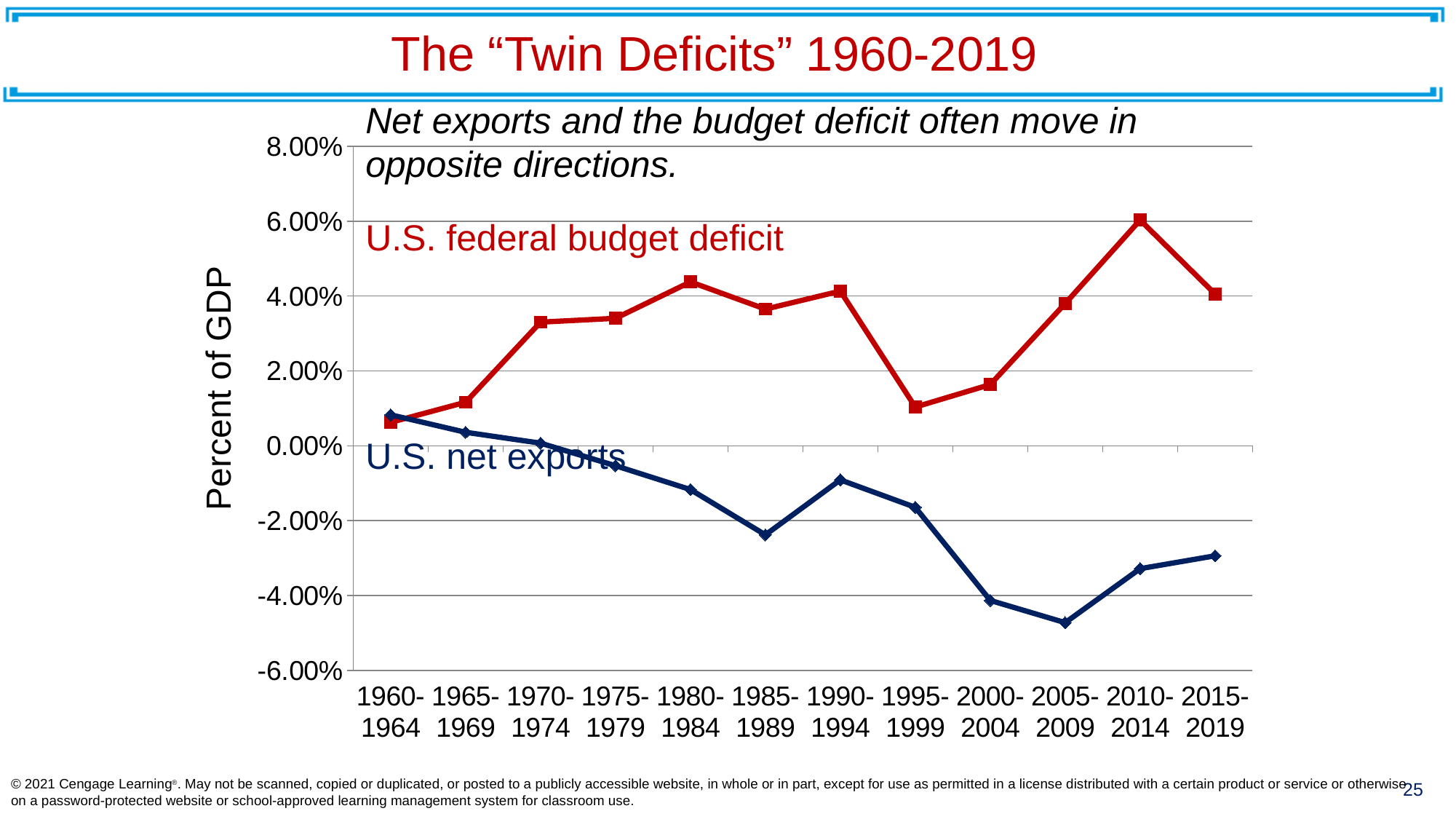
Is the U.S. federal budget deficit for 2010-2014 greater or less than 4.00%? greater Is the U.S. federal budget deficit for 1995-1999 greater or less than 2.00%? less Which is larger, the U.S. federal budget deficit in 2010-2014 or in 2015-2019? 2010-2014 In which period is the U.S. federal budget deficit highest? 2010-2014 How many time periods are shown along the x axis? 12 What kind of chart is shown on the slide? line chart In which period are U.S. net exports highest? 1960-1964 In which period are U.S. net exports lowest? 2005-2009 Do U.S. net exports generally rise or fall from 1960-1964 to 2005-2009? fall Is the value of U.S. net exports for 2005-2009 greater or less than -4.00%? less How many series are plotted on the chart? 2 What is the label on the vertical axis of the chart? Percent of GDP